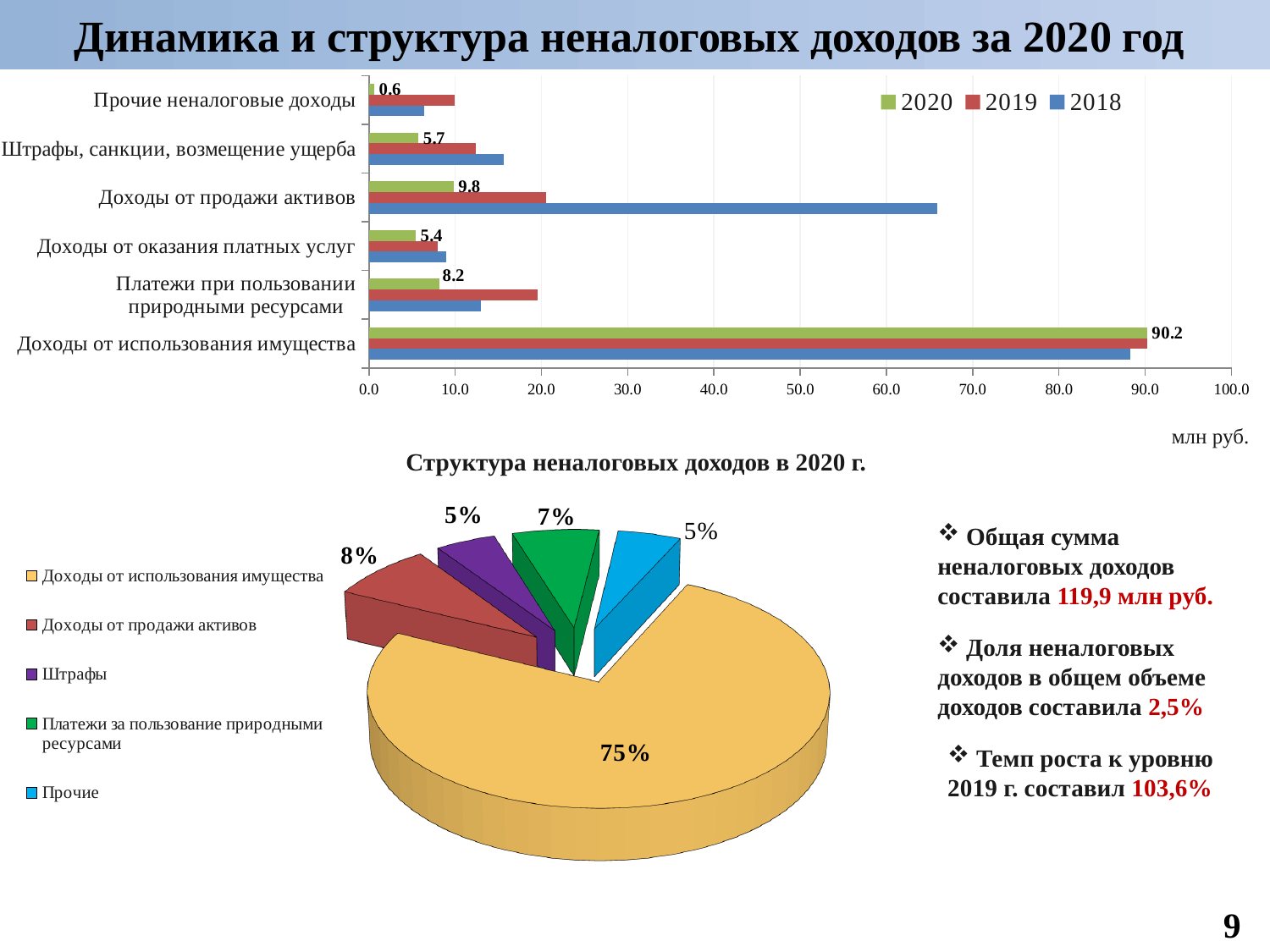
In the top bar chart, which category has the lowest 2020 value? Прочие неналоговые доходы In the top bar chart, how many categories are shown? 6 In the top bar chart, what is the 2020 value for Доходы от продажи активов? 9.8 In the top bar chart, how many series does the legend list? 3 In the pie chart Структура неналоговых доходов в 2020 г., what share does Платежи за пользование природными ресурсами have? 7% In the top bar chart, is the 2018 value for Доходы от продажи активов greater or less than 60.0? greater What type of chart is the chart titled Структура неналоговых доходов в 2020 г.? Pie chart In the top bar chart, what is the 2020 value for Прочие неналоговые доходы? 0.6 In the pie chart Структура неналоговых доходов в 2020 г., what share does Доходы от использования имущества have? 75% In the top bar chart, what is the difference between the 2020 values for Доходы от продажи активов and Штрафы, санкции, возмещение ущерба? 4.1 In the top bar chart, what is the 2020 value for Доходы от использования имущества? 90.2 In the top bar chart, which category has the highest 2020 value? Доходы от использования имущества